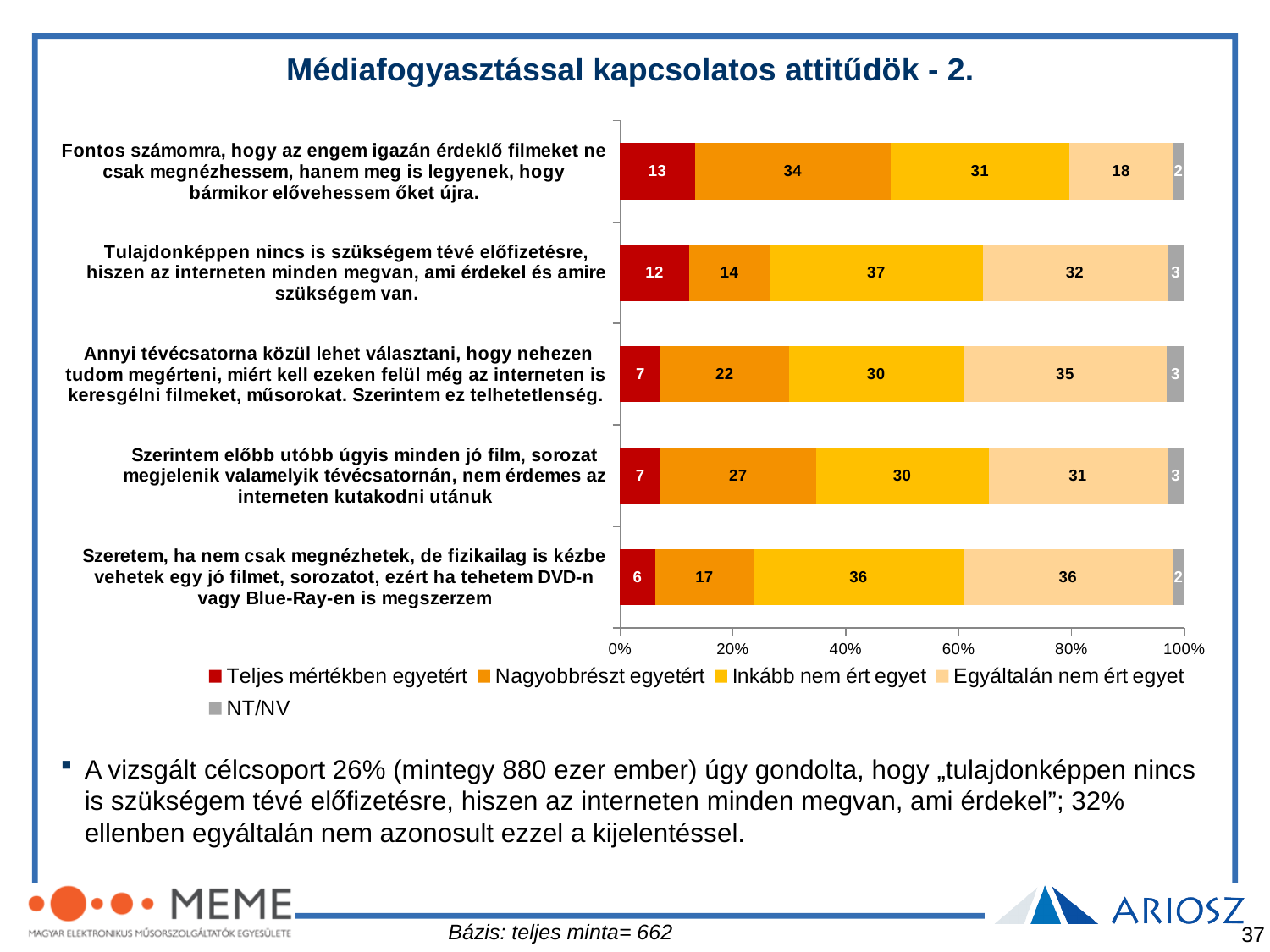
How many series does the legend list? 5 What is the value of "Teljes mértékben egyetért" for the statement "Fontos számomra, hogy az engem igazán érdeklő filmeket ne csak megnézhessem..."? 13 Which legend entry is shown in grey? NT/NV Which is larger: the "Egyáltalán nem ért egyet" value for "Szerintem előbb utóbb úgyis minden jó film..." or for "Szeretem, ha nem csak megnézhetek..."? Szeretem, ha nem csak megnézhetek... (36) What is the value of "Nagyobbrészt egyetért" for the statement "Szeretem, ha nem csak megnézhetek, de fizikailag is kézbe vehetek egy jó filmet..."? 17 Which statement has the lowest "Teljes mértékben egyetért" value? Szeretem, ha nem csak megnézhetek, de fizikailag is kézbe vehetek egy jó filmet, sorozatot, ezért ha tehetem DVD-n vagy Blue-Ray-en is megszerzem What is the value of "Inkább nem ért egyet" for the statement "Tulajdonképpen nincs is szükségem tévé előfizetésre..."? 37 What is the value of "Egyáltalán nem ért egyet" for the statement "Annyi tévécsatorna közül lehet választani..."? 35 What is the difference between the "Nagyobbrészt egyetért" values for "Fontos számomra..." (34) and "Tulajdonképpen nincs is szükségem tévé előfizetésre..." (14)? 20 What kind of chart is shown on the slide? Stacked horizontal bar chart How many statements (bars) are shown in the chart? 5 Which statement has the highest "Nagyobbrészt egyetért" value? Fontos számomra, hogy az engem igazán érdeklő filmeket ne csak megnézhessem, hanem meg is legyenek, hogy bármikor elővehessem őket újra.